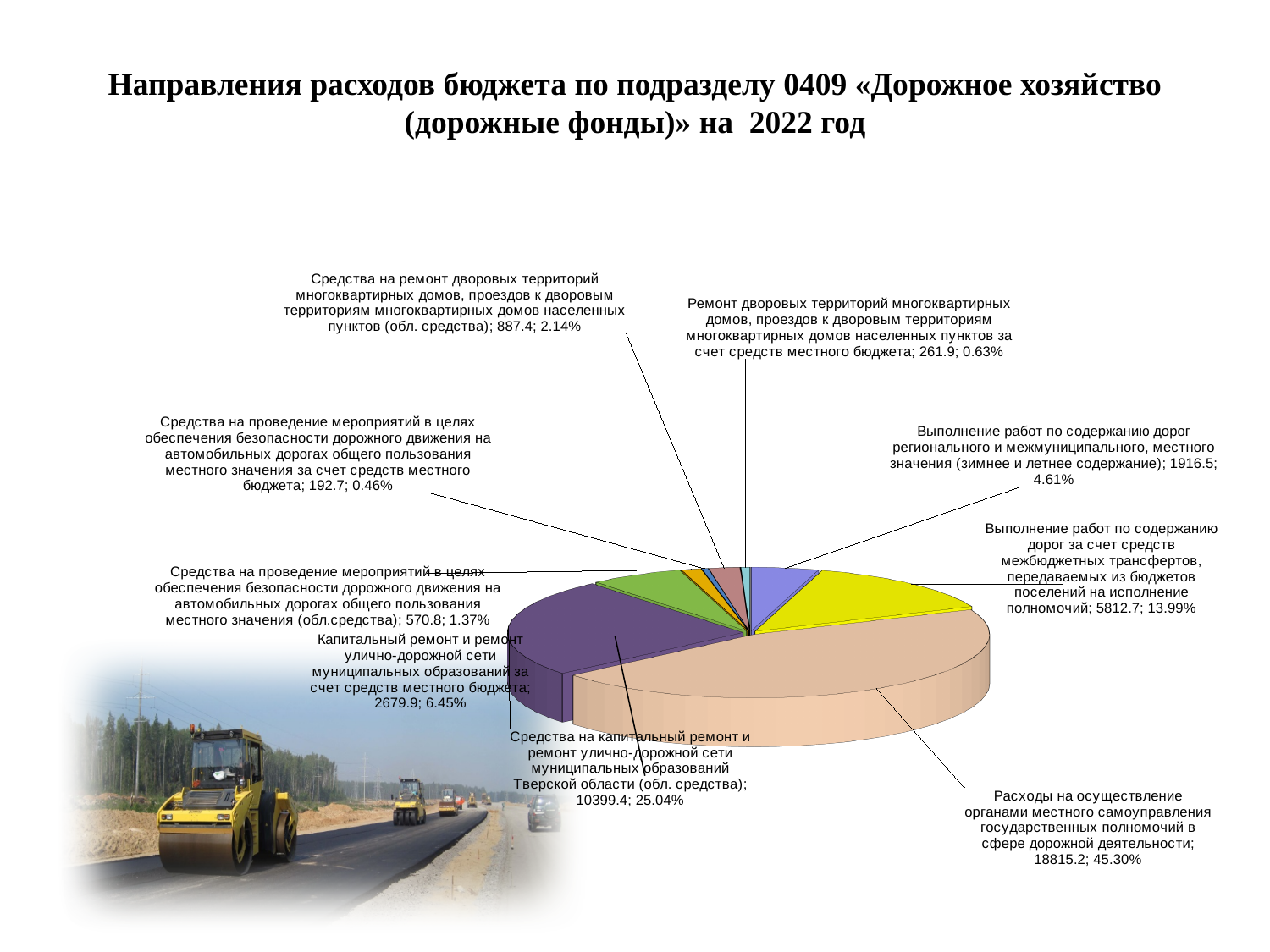
How many slices does the pie chart have? 9 Which is larger: the value for «Средства на ремонт дворовых территорий многоквартирных домов, проездов к дворовым территориям многоквартирных домов населенных пунктов (обл. средства)» or for «Ремонт дворовых территорий многоквартирных домов, проездов к дворовым территориям многоквартирных домов населенных пунктов за счет средств местного бюджета»? Средства на ремонт дворовых территорий многоквартирных домов, проездов к дворовым территориям многоквартирных домов населенных пунктов (обл. средства) What is the value for «Выполнение работ по содержанию дорог регионального и межмуниципального, местного значения (зимнее и летнее содержание)»? 1916.5 What kind of chart is shown on the slide? pie chart Which category has the smallest slice of the pie? Средства на проведение мероприятий в целях обеспечения безопасности дорожного движения на автомобильных дорогах общего пользования местного значения за счет средств местного бюджета What is the value for «Средства на капитальный ремонт и ремонт улично-дорожной сети муниципальных образований Тверской области (обл. средства)»? 10399.4 What share of the pie does «Выполнение работ по содержанию дорог за счет средств межбюджетных трансфертов, передаваемых из бюджетов поселений на исполнение полномочий» represent? 13.99% What is the value for «Расходы на осуществление органами местного самоуправления государственных полномочий в сфере дорожной деятельности»? 18815.2 What is the title of the chart on the slide? Направления расходов бюджета по подразделу 0409 «Дорожное хозяйство (дорожные фонды)» на 2022 год What share of the pie does «Капитальный ремонт и ремонт улично-дорожной сети муниципальных образований за счет средств местного бюджета» represent? 6.45% Which category has the largest slice of the pie? Расходы на осуществление органами местного самоуправления государственных полномочий в сфере дорожной деятельности What is the difference between the values for «Расходы на осуществление органами местного самоуправления государственных полномочий в сфере дорожной деятельности» and «Средства на капитальный ремонт и ремонт улично-дорожной сети муниципальных образований Тверской области (обл. средства)»? 8415.8